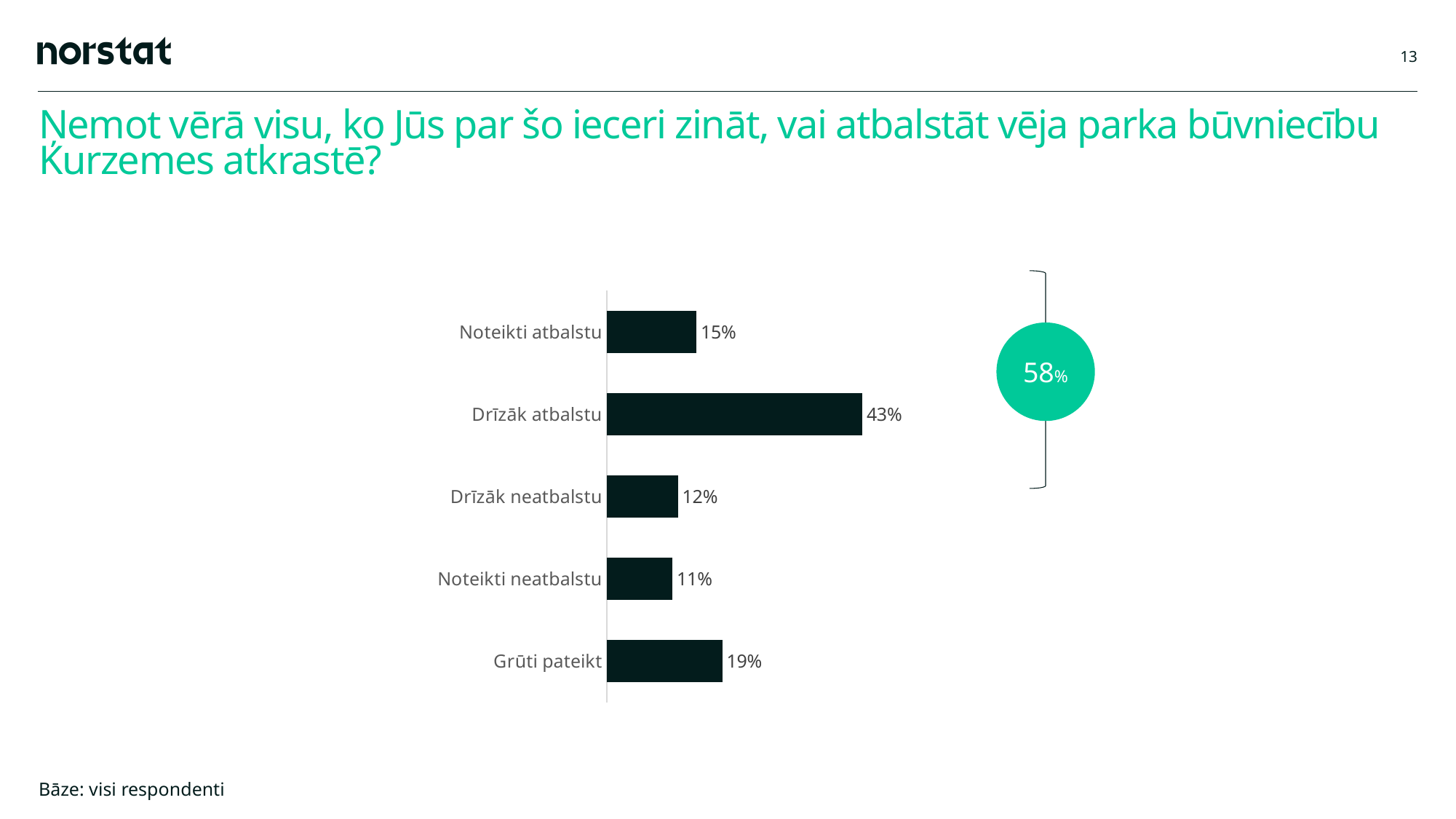
Which is larger, "Grūti pateikt" or "Drīzāk neatbalstu"? Grūti pateikt What is the value for "Noteikti neatbalstu"? 11% What is the value for "Noteikti atbalstu"? 15% What is the value for "Drīzāk atbalstu"? 43% What is the difference between "Drīzāk atbalstu" and "Noteikti atbalstu"? 28% What percentage is shown in the green circle next to the chart? 58% What is the combined value of "Noteikti atbalstu" and "Drīzāk atbalstu"? 58% What kind of chart is shown on the slide? Bar chart How many categories are shown in the chart? 5 Which category has the lowest value? Noteikti neatbalstu Which category has the highest value? Drīzāk atbalstu What is the value for "Grūti pateikt"? 19%